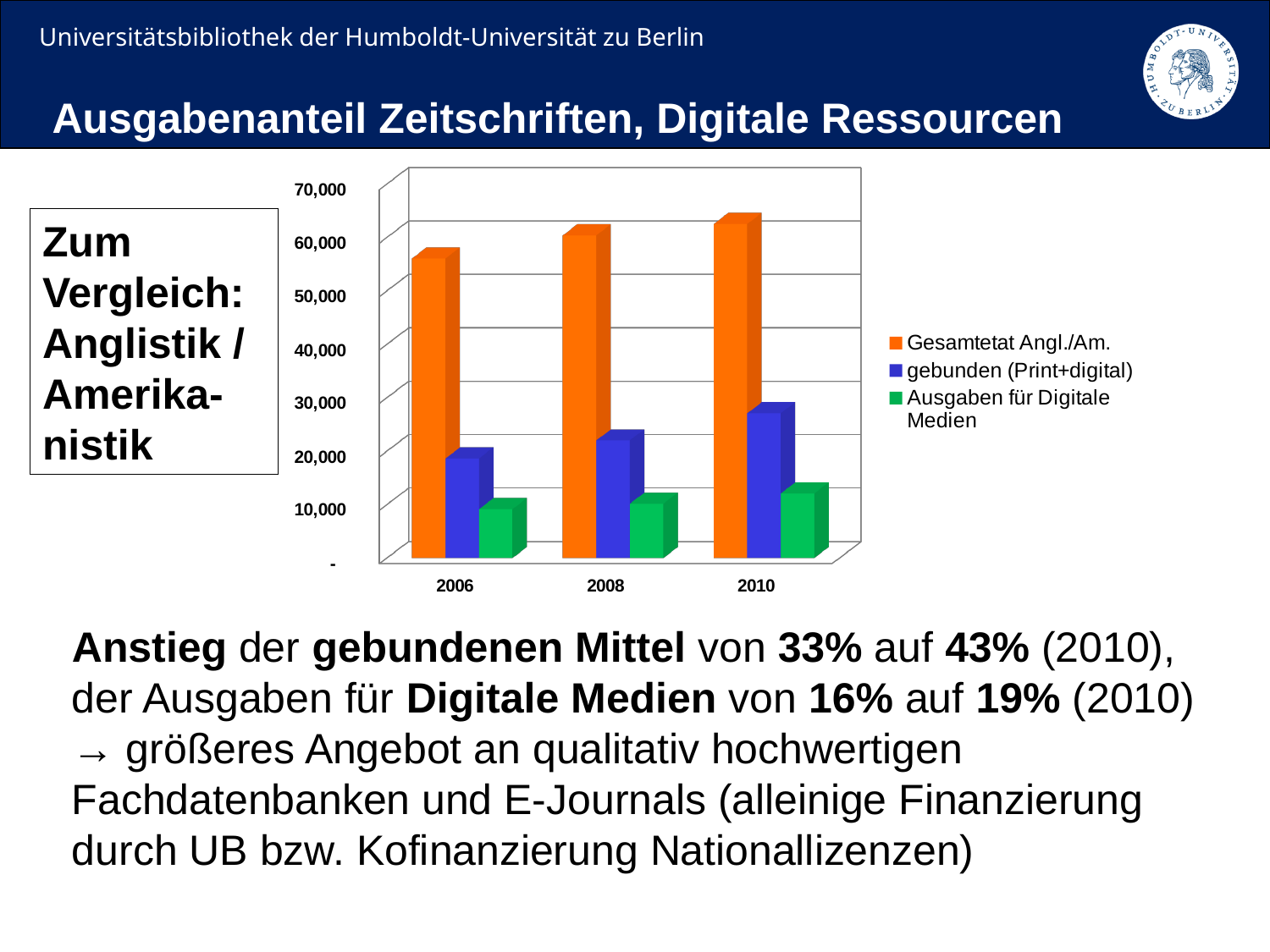
Do the values for 'gebunden (Print+digital)' rise or fall from 2006 to 2010? rise In which year is the value for 'gebunden (Print+digital)' highest? 2010 Which years are shown on the x axis of the chart? 2006, 2008, 2010 Is the value for 'gebunden (Print+digital)' in 2006 greater or less than 30,000? less Is the value for 'Ausgaben für Digitale Medien' in 2010 greater or less than 20,000? less What kind of chart is shown on the slide? bar chart How many years are shown on the x axis of the chart? 3 Which colour represents the series 'Gesamtetat Angl./Am.' in the chart? orange Is the value for 'Gesamtetat Angl./Am.' in 2006 greater or less than 50,000? greater How many series does the chart's legend list? 3 In 2010, which is larger: 'gebunden (Print+digital)' or 'Ausgaben für Digitale Medien'? gebunden (Print+digital)